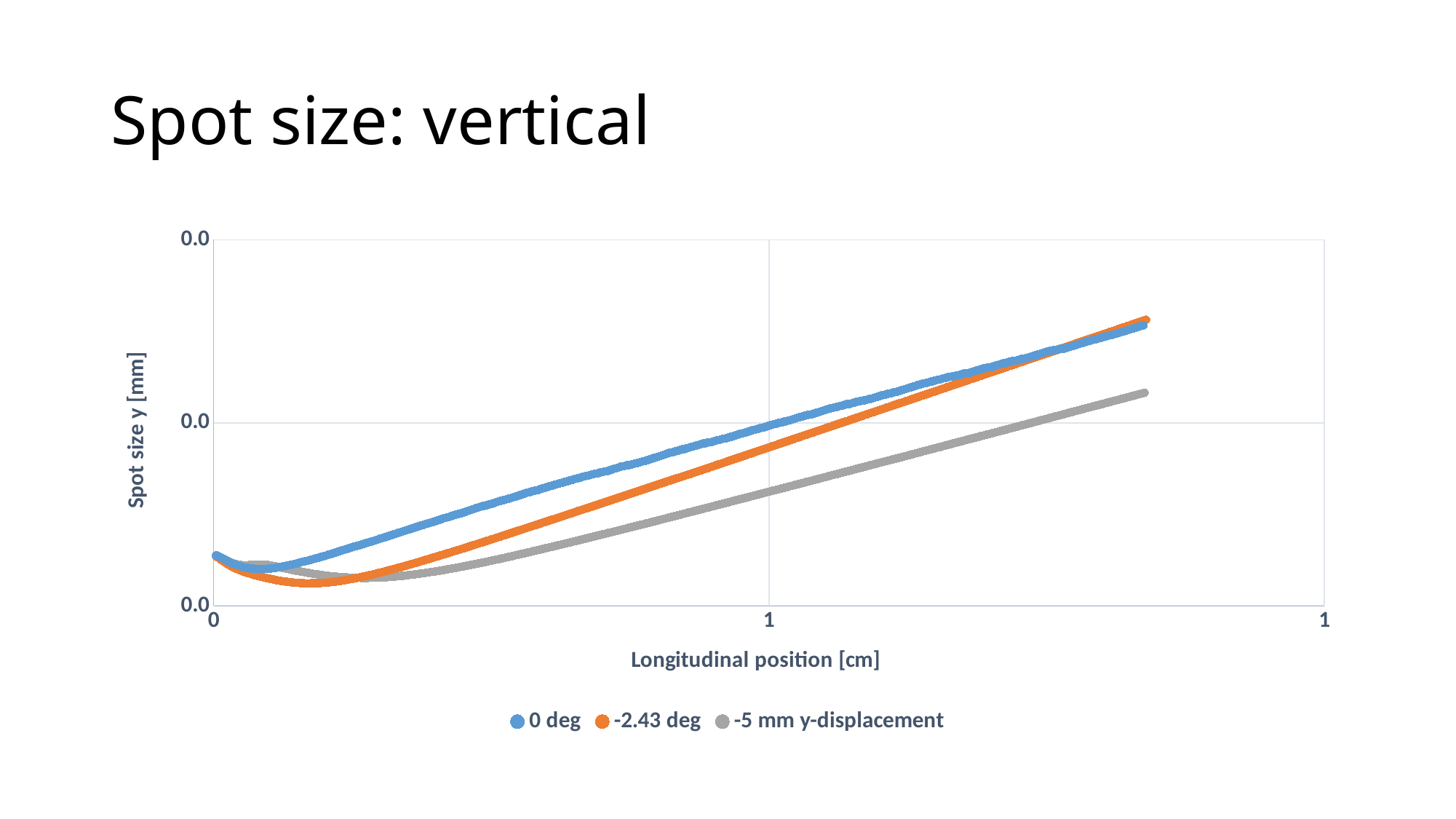
Which series dips to the lowest spot size near the left side of the chart before rising? -2.43 deg Which series is plotted in gray? -5 mm y-displacement How many series does the legend list? 3 At the right end of the plotted data, is the value for 0 deg larger or smaller than the value for -5 mm y-displacement? larger What is the label of the x axis? Longitudinal position [cm] What is the title of the slide's chart? Spot size: vertical Which series reaches the lowest spot size at the right end of the chart? -5 mm y-displacement At the vertical gridline labelled 1, which is larger: the value for -2.43 deg or the value for -5 mm y-displacement? -2.43 deg Overall, do the spot size values rise or fall as longitudinal position increases? rise At the vertical gridline labelled 1, which series has the highest spot size? 0 deg What kind of chart is shown on the slide? scatter chart